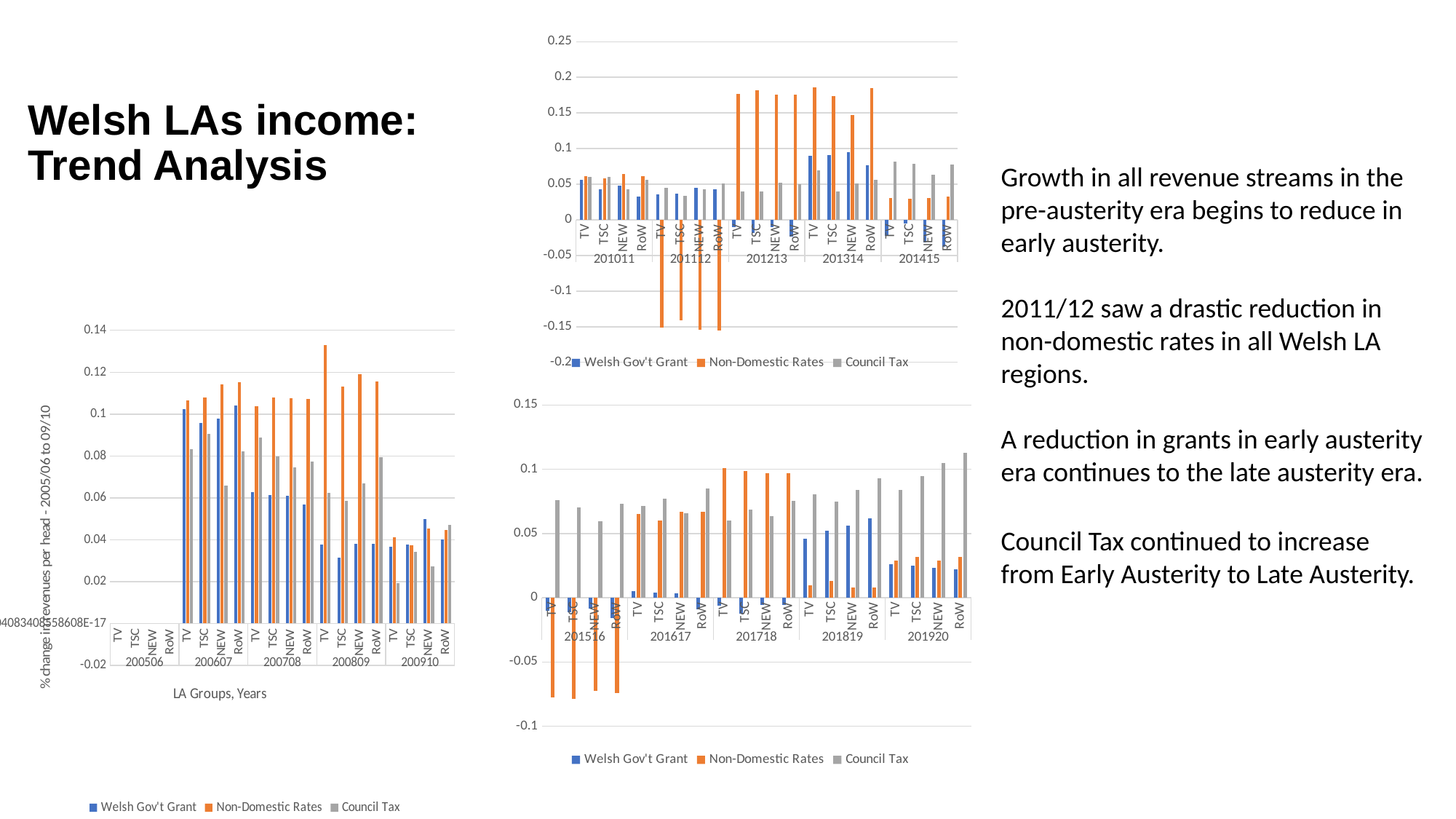
In the bottom-right chart, is the Non-Domestic Rates value for TV in 201516 greater or less than -0.05? less What kind of chart is the bottom-left chart on the slide? bar chart What is the x-axis title of the bottom-left chart? LA Groups, Years In the top-right chart, is the Welsh Gov't Grant value for TV in 201314 greater or less than 0.05? greater In the top-right chart, is the Non-Domestic Rates value for TV in 201112 greater or less than -0.1? less In the bottom-left chart, which year group and LA group has the highest Non-Domestic Rates bar? TV in 200809 How many year groups are shown along the x axis of the bottom-right chart? 5 How many series does the legend of the top-right chart list? 3 In the top-right chart, which is larger for TV in 201112: Non-Domestic Rates or Council Tax? Council Tax